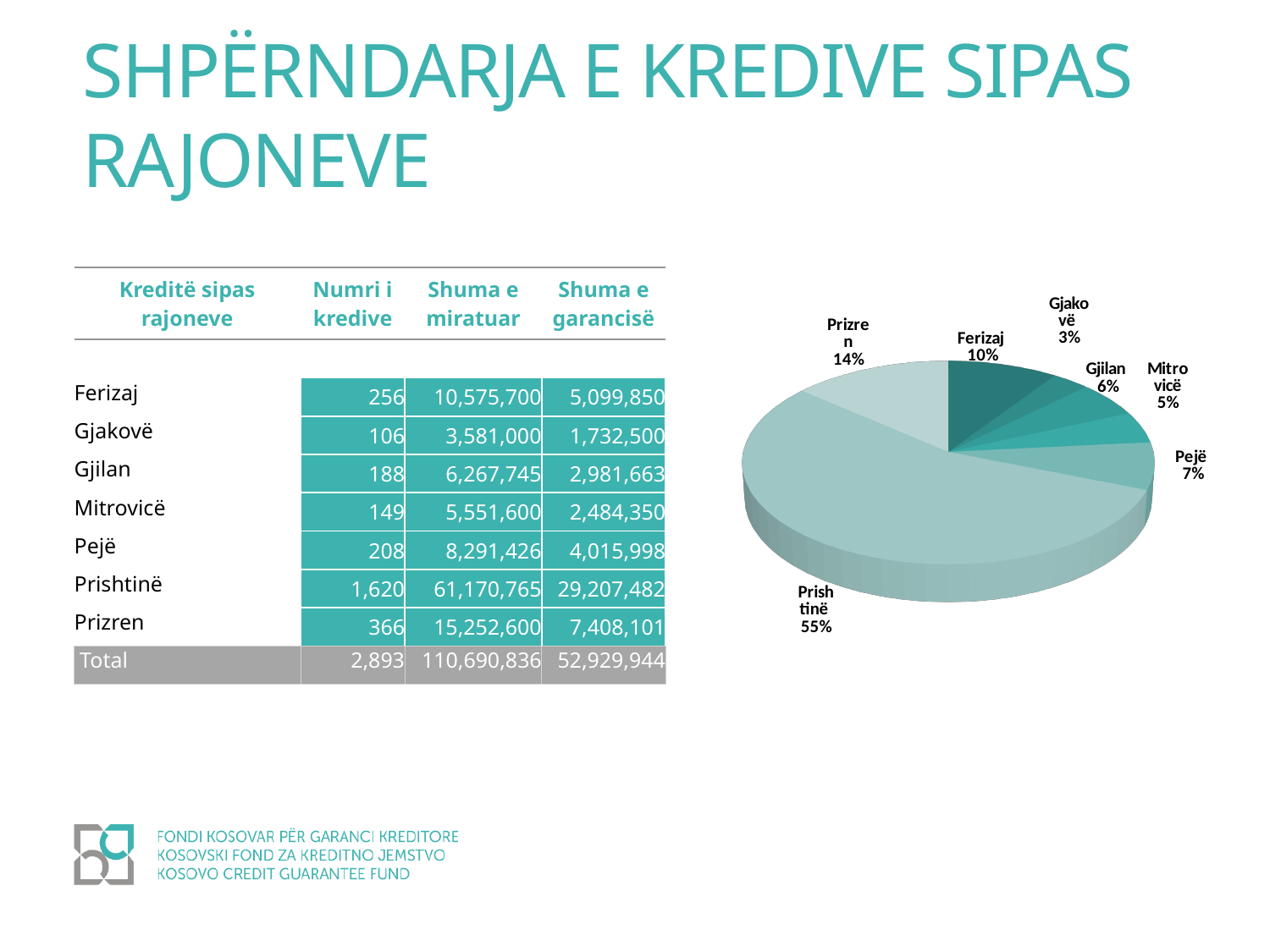
In the pie chart, what is the difference in percentage points between Prizren and Ferizaj? 4 Which region has the smallest slice in the pie chart? Gjakovë What share of the pie chart does Ferizaj have? 10% What share of the pie chart does Gjakovë have? 3% Which region has the largest slice in the pie chart? Prishtinë What share of the pie chart does Prishtinë have? 55% In the pie chart, what is the difference in percentage points between Prishtinë and Prizren? 41 How many slices does the pie chart have? 7 In the pie chart, which is larger, the slice for Pejë or the slice for Gjilan? Pejë What kind of chart is shown on the slide? pie chart